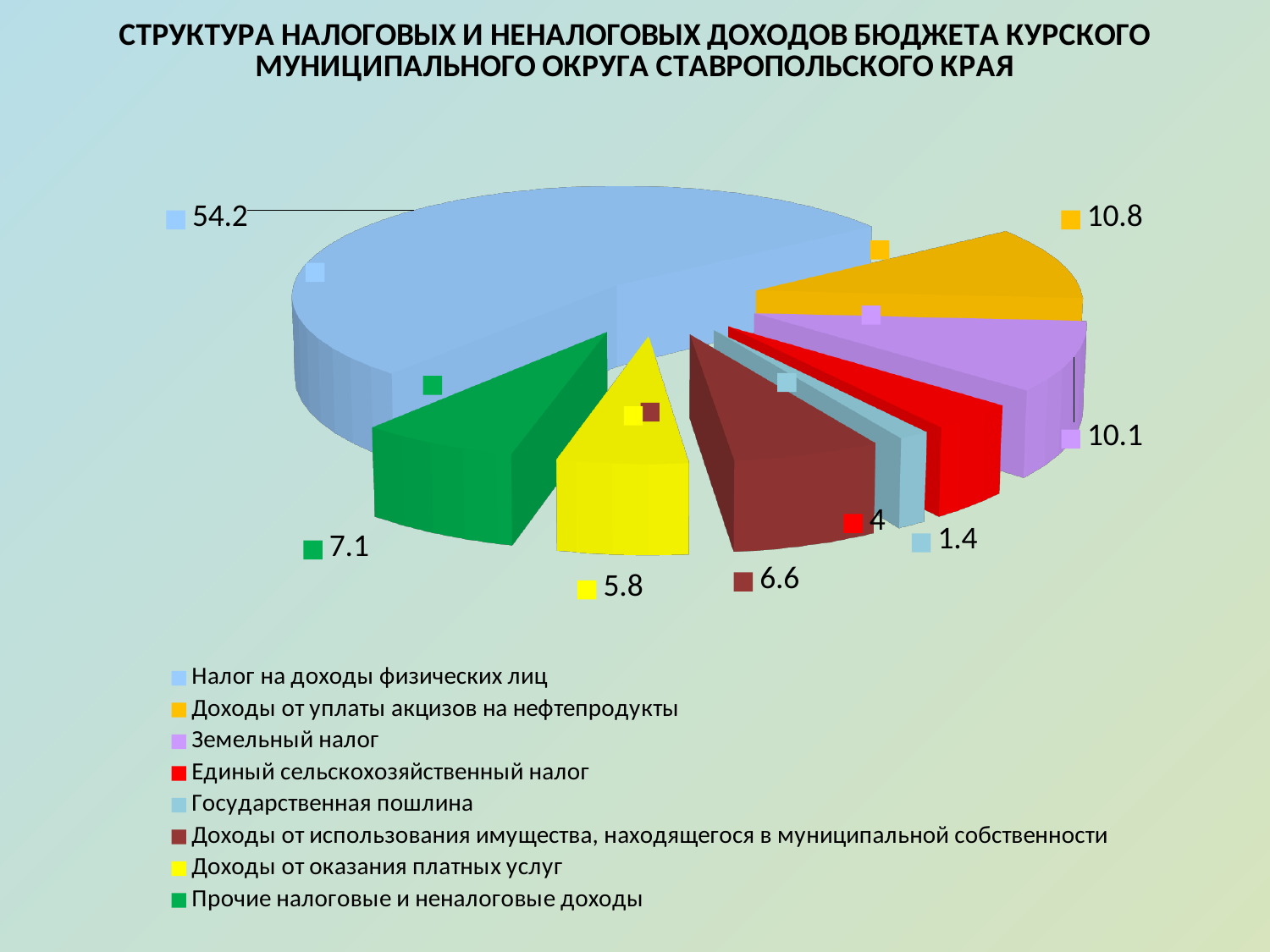
What is the value for Государственная пошлина? 1.4 What kind of chart is shown on the slide? pie chart What is the value for Доходы от уплаты акцизов на нефтепродукты? 10.8 What is the value for Налог на доходы физических лиц? 54.2 What is the value for Доходы от оказания платных услуг? 5.8 Which is larger: the value for Единый сельскохозяйственный налог or the value for Доходы от оказания платных услуг? Доходы от оказания платных услуг Which category has the smallest slice of the pie? Государственная пошлина How many categories does the legend list? 8 Which category has the largest slice of the pie? Налог на доходы физических лиц What is the value for Земельный налог? 10.1 What colour is the slice for Земельный налог? purple What is the difference between the values for Прочие налоговые и неналоговые доходы and Доходы от использования имущества, находящегося в муниципальной собственности? 0.5